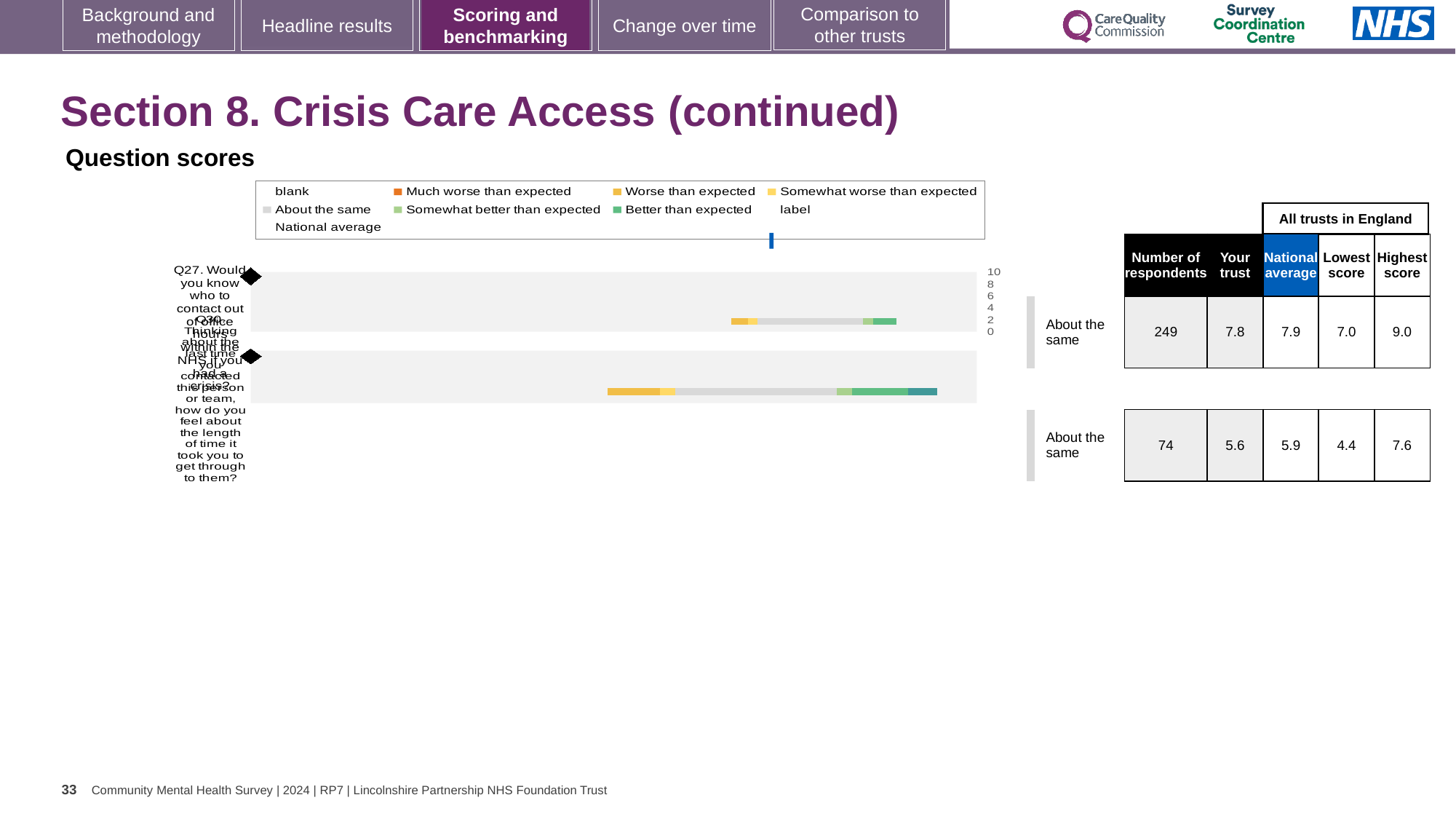
What is the difference between the Highest score and the Lowest score for the second question (Q28)? 3.2 For Q27, which is larger: the 'Your trust' score or the National average? National average What is the Lowest score across all trusts in England for the second question (Q28)? 4.4 What is the heading above the chart? Question scores In the table next to the chart, what is the National average for Q27? 7.9 What benchmark category is shown for Q27 in the chart? About the same In the table next to the chart, what is the 'Your trust' score for Q27? 7.8 How many survey questions are plotted in the Question scores chart? 2 What is the 'Your trust' score for the second question (Q28) in the table? 5.6 How many respondents are listed for Q27 in the table? 249 What kind of chart is shown under 'Question scores'? bar chart What is the Highest score across all trusts in England for Q27? 9.0